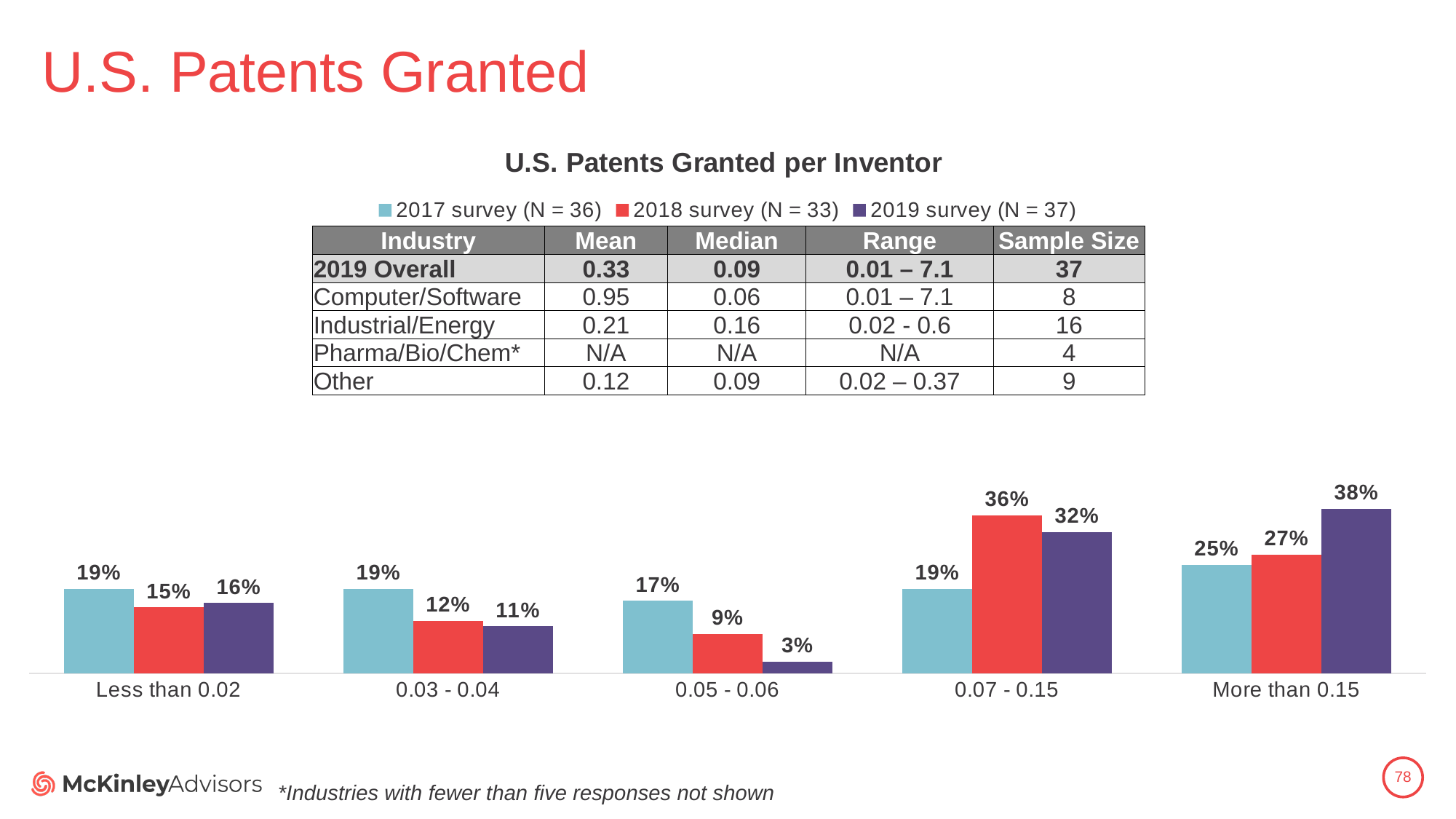
How many categories are shown on the x axis of the chart? 5 Which category has the highest value for the 2018 survey? 0.07 - 0.15 What is the difference between the 2018 survey and 2019 survey values in the '0.07 - 0.15' category? 4% What kind of chart is shown on the slide? Bar chart Do the 2019 survey values rise or fall from '0.05 - 0.06' to 'More than 0.15'? Rise Which category has the lowest value for the 2019 survey? 0.05 - 0.06 What is the title of the chart? U.S. Patents Granted per Inventor Which is larger in the 'Less than 0.02' category: the 2017 survey value or the 2019 survey value? 2017 survey How many series does the chart legend list? 3 What is the value for the 2017 survey in the '0.05 - 0.06' category? 17% What is the value for the 2019 survey in the 'More than 0.15' category? 38% What is the value for the 2018 survey in the '0.07 - 0.15' category? 36%